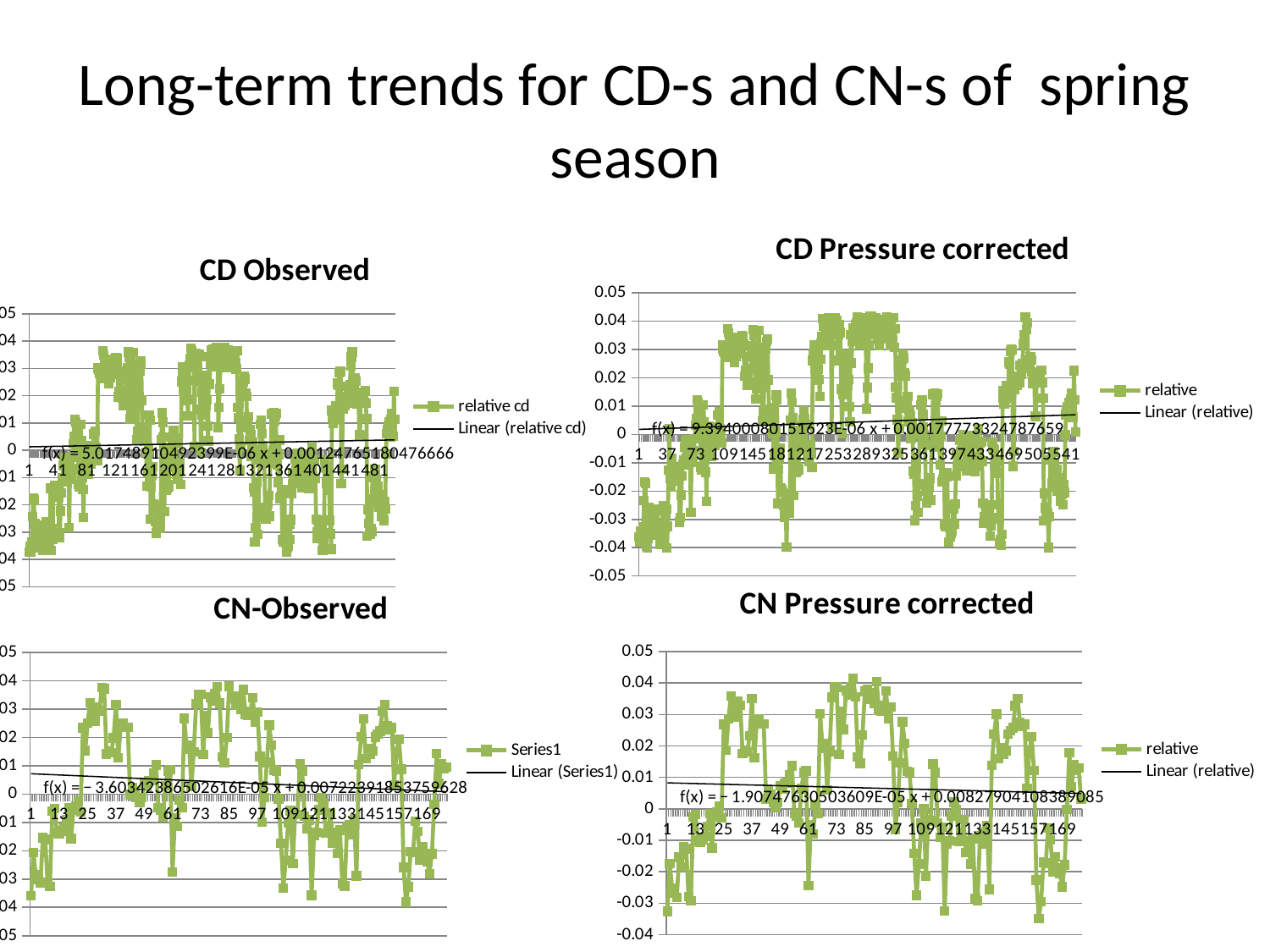
What is the highest value shown on the y axis of the "CD Pressure corrected" chart? 0.05 According to the trendline equation on the "CD Observed" chart, does the linear trend rise or fall along the x axis? rise In the "CN Pressure corrected" chart, is the first plotted value (at x = 1) greater or less than 0? less How many series does the legend of the "CD Pressure corrected" chart list? 2 According to the trendline equation on the "CN Pressure corrected" chart, does the linear trend rise or fall along the x axis? fall In the "CN-Observed" chart, what are the two legend entries? Series1 and Linear (Series1) In the "CD Observed" chart, what is the name of the plotted data series in the legend? relative cd What kind of chart is the "CD Observed" chart? line chart According to the trendline equation on the "CD Pressure corrected" chart, does the linear trend rise or fall along the x axis? rise In the "CD Pressure corrected" chart, is the first plotted value (at x = 1) greater or less than 0? less What is the lowest value shown on the y axis of the "CN Pressure corrected" chart? -0.04